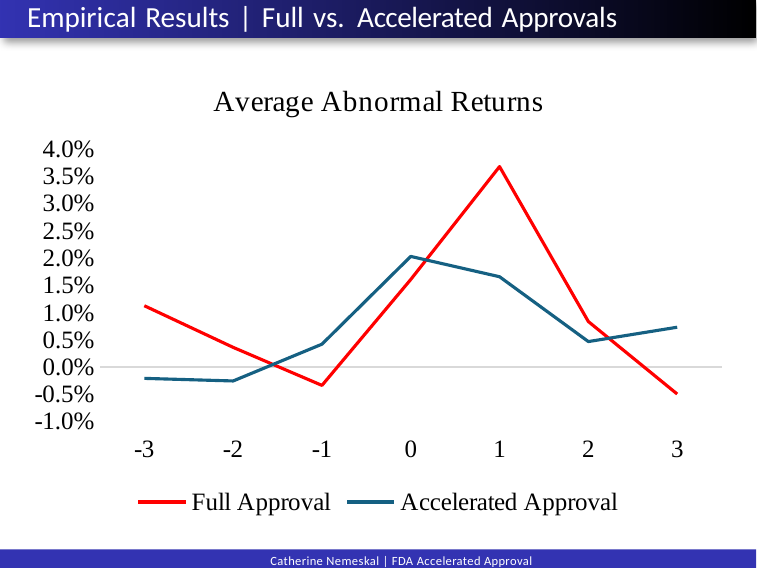
At which x-axis value does the Accelerated Approval series reach its highest point? 0 At x = 1, which series has the higher value, Full Approval or Accelerated Approval? Full Approval Is the Full Approval value at x = -1 greater or less than 0.0%? less Is the Full Approval value at x = 1 greater or less than 3.0%? greater What kind of chart is shown on the slide? line chart How many series does the legend list? 2 At which x-axis value does the Full Approval series reach its highest point? 1 How many points are plotted along the x axis for each series? 7 At x = 0, which series has the higher value, Full Approval or Accelerated Approval? Accelerated Approval Does the Full Approval series rise or fall from x = 1 to x = 3? fall Is the Accelerated Approval value at x = 0 greater or less than 1.5%? greater What is the title of the chart? Average Abnormal Returns